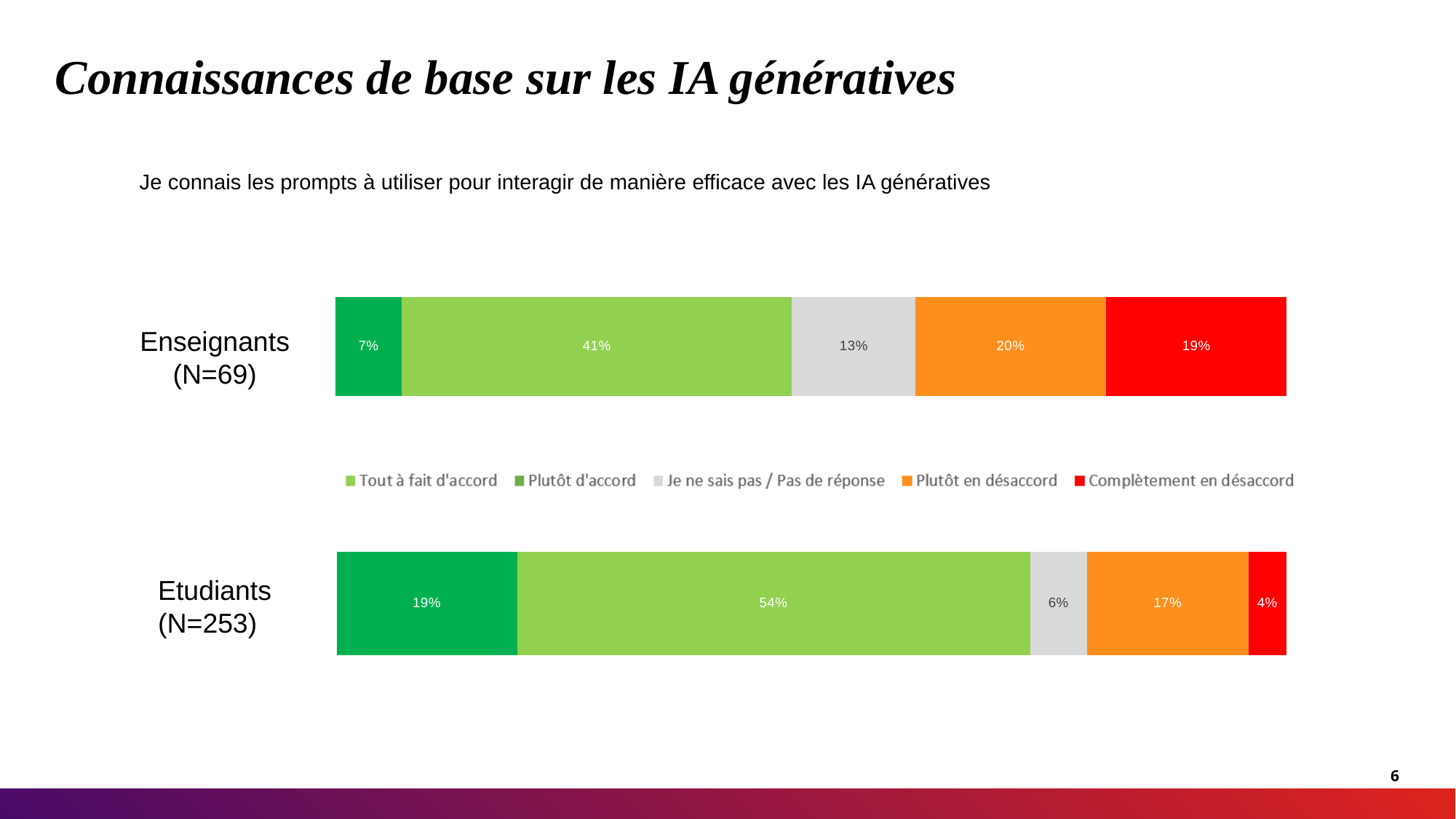
In the Enseignants (N=69) bar, what percentage is shown for "Je ne sais pas / Pas de réponse"? 13% How many percentage points higher is "Complètement en désaccord" for Enseignants (N=69) than for Etudiants (N=253)? 15 percentage points In the Enseignants (N=69) bar, what percentage is shown for "Plutôt en désaccord"? 20% In the Etudiants (N=253) bar, what percentage is shown for "Je ne sais pas / Pas de réponse"? 6% How many response categories does the legend list? 5 What is the value of the largest segment in the Etudiants (N=253) bar? 54% Which group has the higher share of "Plutôt en désaccord", Enseignants (N=69) or Etudiants (N=253)? Enseignants (N=69) What kind of chart is used on this slide? Stacked bar chart In the Etudiants (N=253) bar, what percentage is shown for "Complètement en désaccord"? 4% What colour represents "Complètement en désaccord" in the legend? Red What is the value of the smallest segment in the Enseignants (N=69) bar? 7% In the Enseignants (N=69) bar, what percentage is shown for "Complètement en désaccord"? 19%